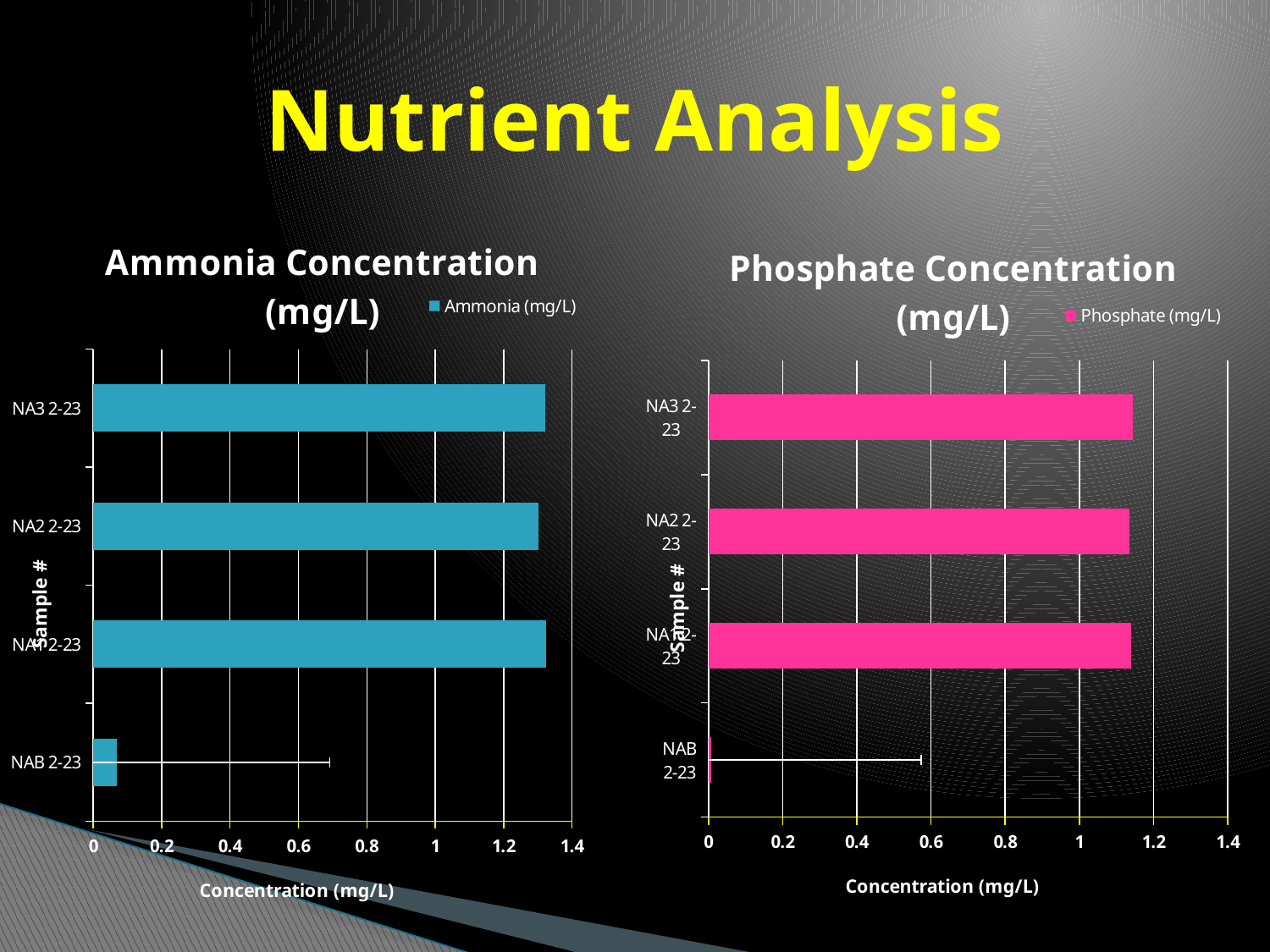
In the Ammonia Concentration (mg/L) chart, which sample has the lowest concentration? NAB 2-23 In the Phosphate Concentration (mg/L) chart, which sample has the lowest concentration? NAB 2-23 How many samples are plotted in the Phosphate Concentration (mg/L) chart? 4 What legend entry is shown on the Phosphate Concentration (mg/L) chart? Phosphate (mg/L) In the Ammonia Concentration (mg/L) chart, is the value for NAB 2-23 greater or less than 0.2? less In the Ammonia Concentration (mg/L) chart, is the value for NA3 2-23 greater or less than 1.2? greater In the Phosphate Concentration (mg/L) chart, is the value for NA1 2-23 greater or less than 1.2? less What type of chart is the Ammonia Concentration (mg/L) chart? bar chart In the Ammonia Concentration (mg/L) chart, which is larger, the value for NA2 2-23 or the value for NAB 2-23? NA2 2-23 How many series does the legend of the Ammonia Concentration (mg/L) chart list? 1 What is the x-axis title of the Phosphate Concentration (mg/L) chart? Concentration (mg/L)